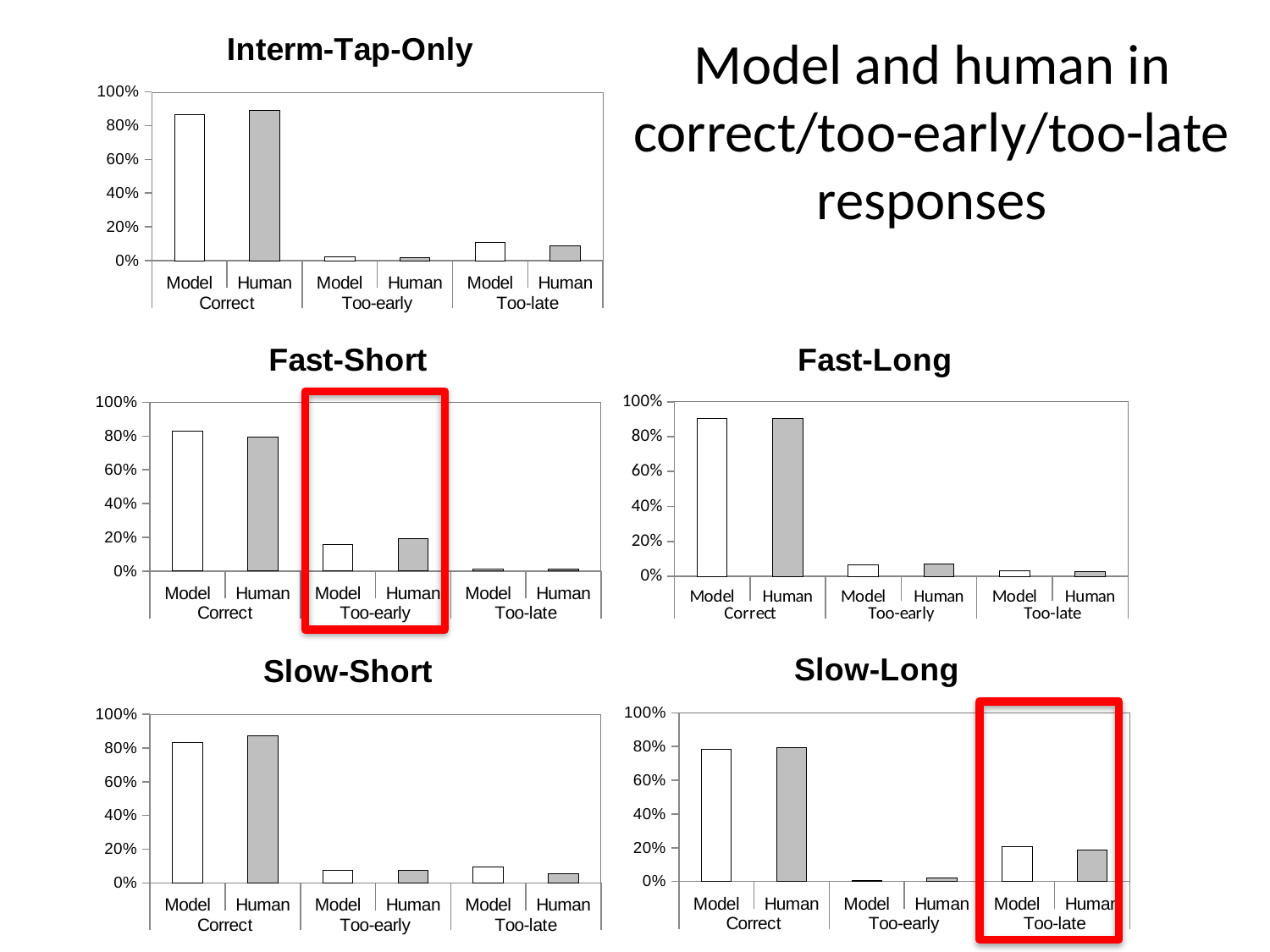
In the Interm-Tap-Only chart, which is larger for Model: the Too-early value or the Too-late value? Too-late In the Interm-Tap-Only chart, is the value for Model in the Correct group greater or less than 80%? greater In the Slow-Long chart, is the value for Model in the Too-late group greater or less than 40%? less In the Slow-Short chart, is the value for Human in the Correct group greater or less than 80%? greater How many charts are shown on the slide? 5 What kind of chart is the Interm-Tap-Only chart? bar chart In the Fast-Short chart, which is larger for Model: the Too-early value or the Too-late value? Too-early In the Slow-Long chart, which response category has the lowest bars? Too-early How many bars are plotted in the Fast-Short chart? 6 How many response categories (groups) are shown on the x axis of the Slow-Long chart? 3 In the Fast-Long chart, which response category has the highest bars? Correct